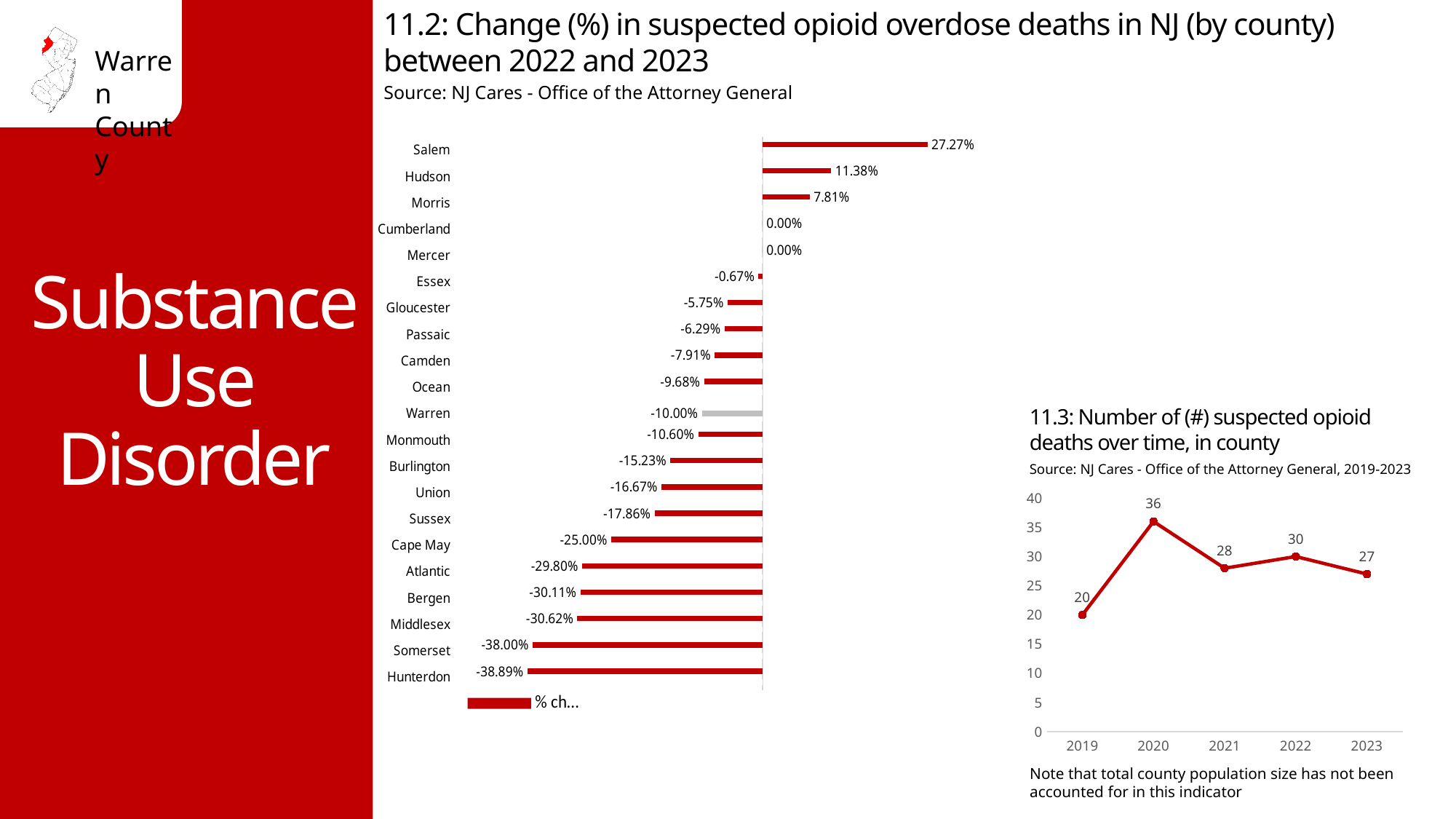
In the chart '11.2: Change (%) in suspected opioid overdose deaths in NJ (by county) between 2022 and 2023', what is the value for Hudson? 11.38% In the chart '11.2: Change (%) in suspected opioid overdose deaths in NJ (by county) between 2022 and 2023', how many counties are shown? 21 In the chart '11.2: Change (%) in suspected opioid overdose deaths in NJ (by county) between 2022 and 2023', what is the value for Warren? -10.00% In the chart '11.2: Change (%) in suspected opioid overdose deaths in NJ (by county) between 2022 and 2023', which is larger, the value for Morris or the value for Hudson? Hudson In the chart '11.3: Number of (#) suspected opioid deaths over time, in county', how many data points are plotted? 5 What kind of chart is '11.3: Number of (#) suspected opioid deaths over time, in county'? Line chart In the chart '11.3: Number of (#) suspected opioid deaths over time, in county', what is the difference between the values for 2020 and 2019? 16 In the chart '11.3: Number of (#) suspected opioid deaths over time, in county', which year has the lowest value? 2019 What kind of chart is '11.2: Change (%) in suspected opioid overdose deaths in NJ (by county) between 2022 and 2023'? Bar chart In the chart '11.2: Change (%) in suspected opioid overdose deaths in NJ (by county) between 2022 and 2023', which county has the highest value? Salem In the chart '11.3: Number of (#) suspected opioid deaths over time, in county', what is the value for 2020? 36 In the chart '11.2: Change (%) in suspected opioid overdose deaths in NJ (by county) between 2022 and 2023', which county has the lowest value? Hunterdon